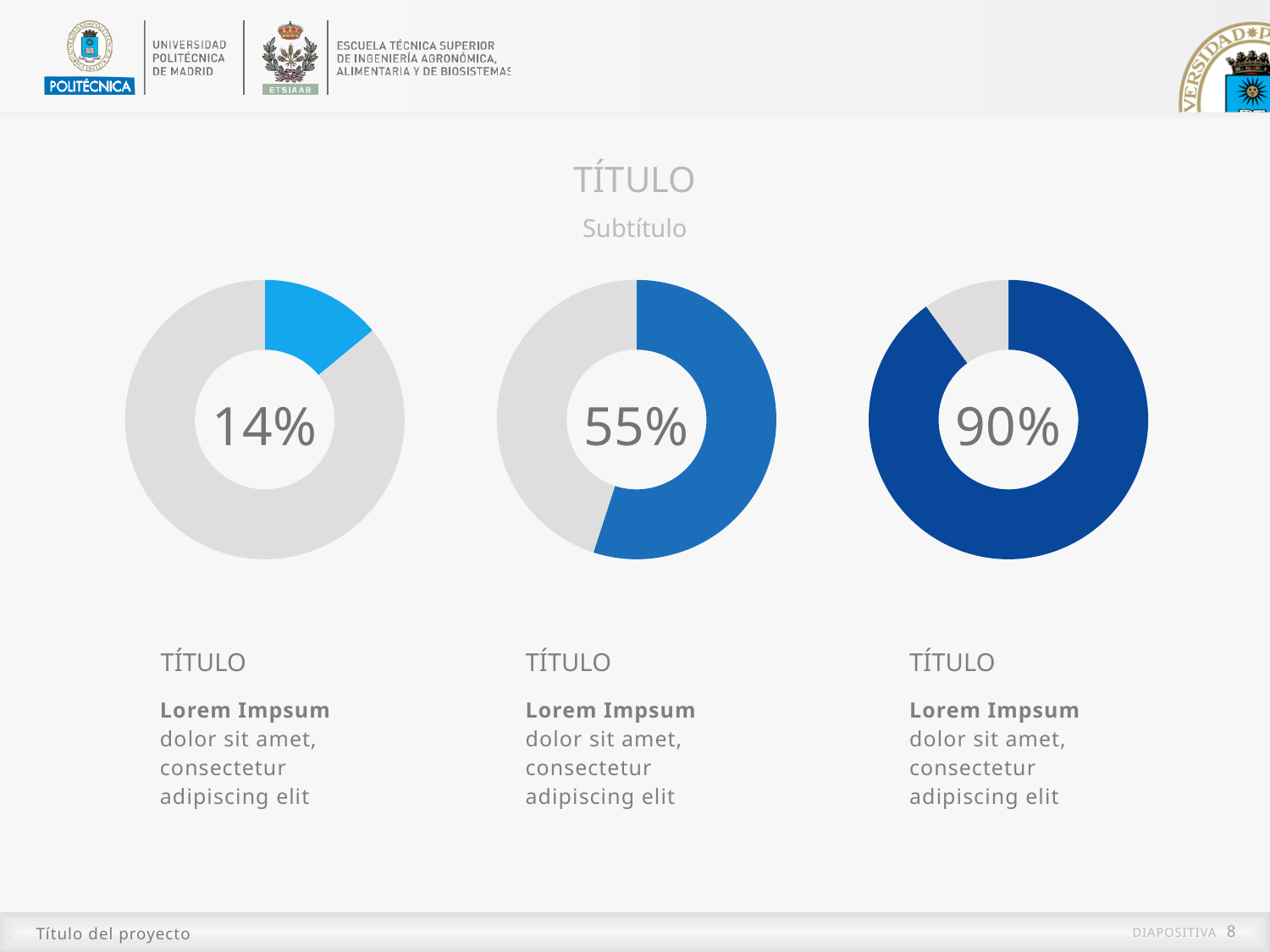
What percentage is shown in the centre of the left donut chart? 14% Which donut chart shows the highest percentage: left, middle or right? Right (90%) Which is larger, the percentage in the middle donut chart or the percentage in the left donut chart? Middle (55%) In the left donut chart, what share of the ring is filled with the coloured (non-grey) segment? 14% What percentage is shown in the centre of the middle donut chart? 55% How many donut charts are on the slide? 3 Which donut chart shows the lowest percentage: left, middle or right? Left (14%) What colour is the filled segment of the right donut chart? Dark blue What kind of chart is used for the three figures on the slide? Donut (pie) chart What is the difference in percentage points between the right donut chart and the middle donut chart? 35 percentage points What is the difference in percentage points between the right donut chart and the left donut chart? 76 percentage points What percentage is shown in the centre of the right donut chart? 90%